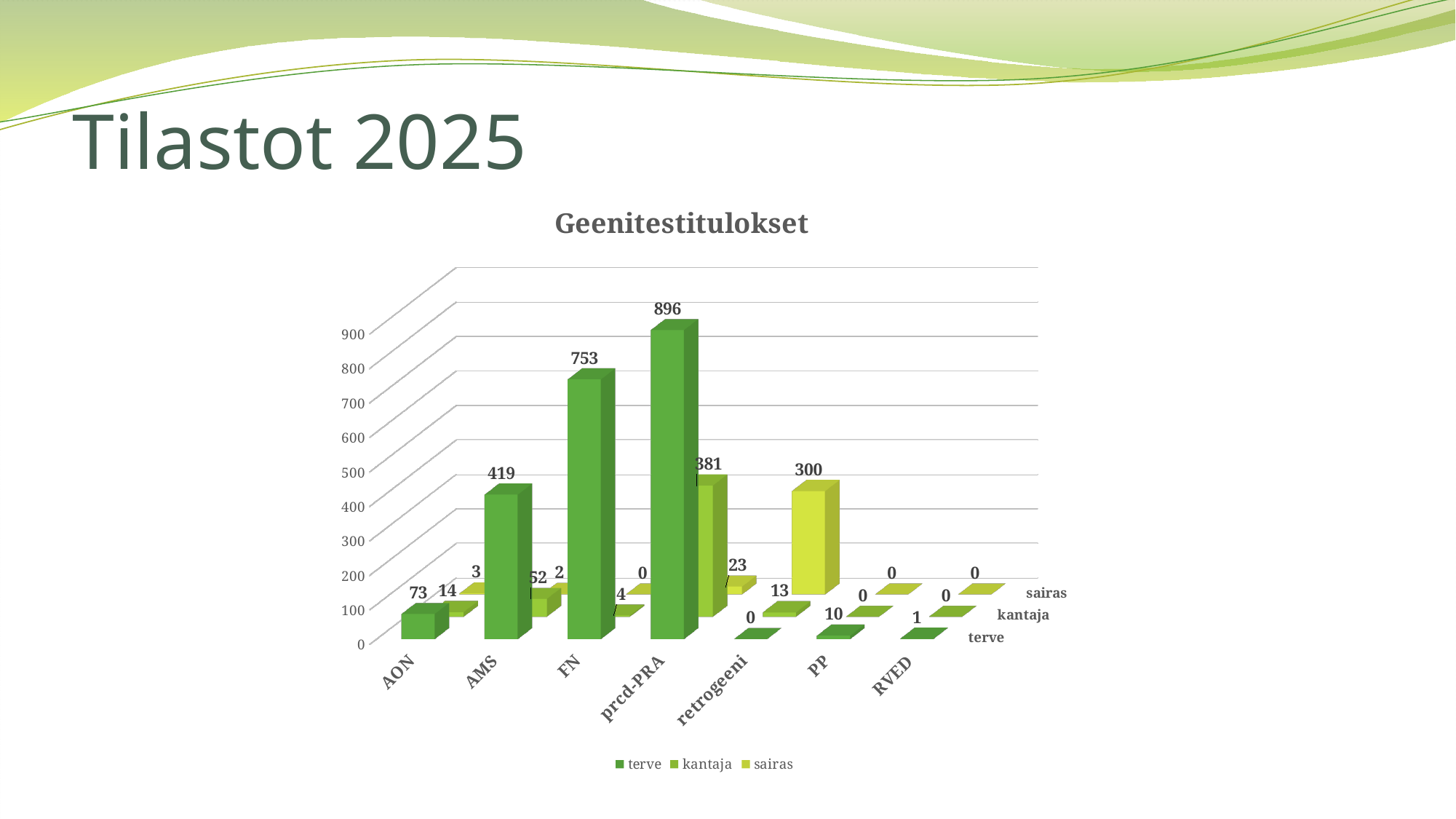
In the Geenitestitulokset chart, what is the sairas value for retrogeeni? 300 In the Geenitestitulokset chart, what is the difference between the terve values for prcd-PRA and FN? 143 How many categories are shown on the x axis of the Geenitestitulokset chart? 7 In the Geenitestitulokset chart, what is the terve value for prcd-PRA? 896 In the Geenitestitulokset chart, which category has the highest terve value? prcd-PRA In the Geenitestitulokset chart, what is the kantaja value for prcd-PRA? 381 What is the title of the chart on the slide? Geenitestitulokset In the Geenitestitulokset chart, what is the terve value for AON? 73 In the Geenitestitulokset chart, which has the larger terve value, AMS or AON? AMS In the Geenitestitulokset chart, what is the terve value for FN? 753 How many series does the legend of the Geenitestitulokset chart list? 3 What kind of chart is shown on the slide? bar chart